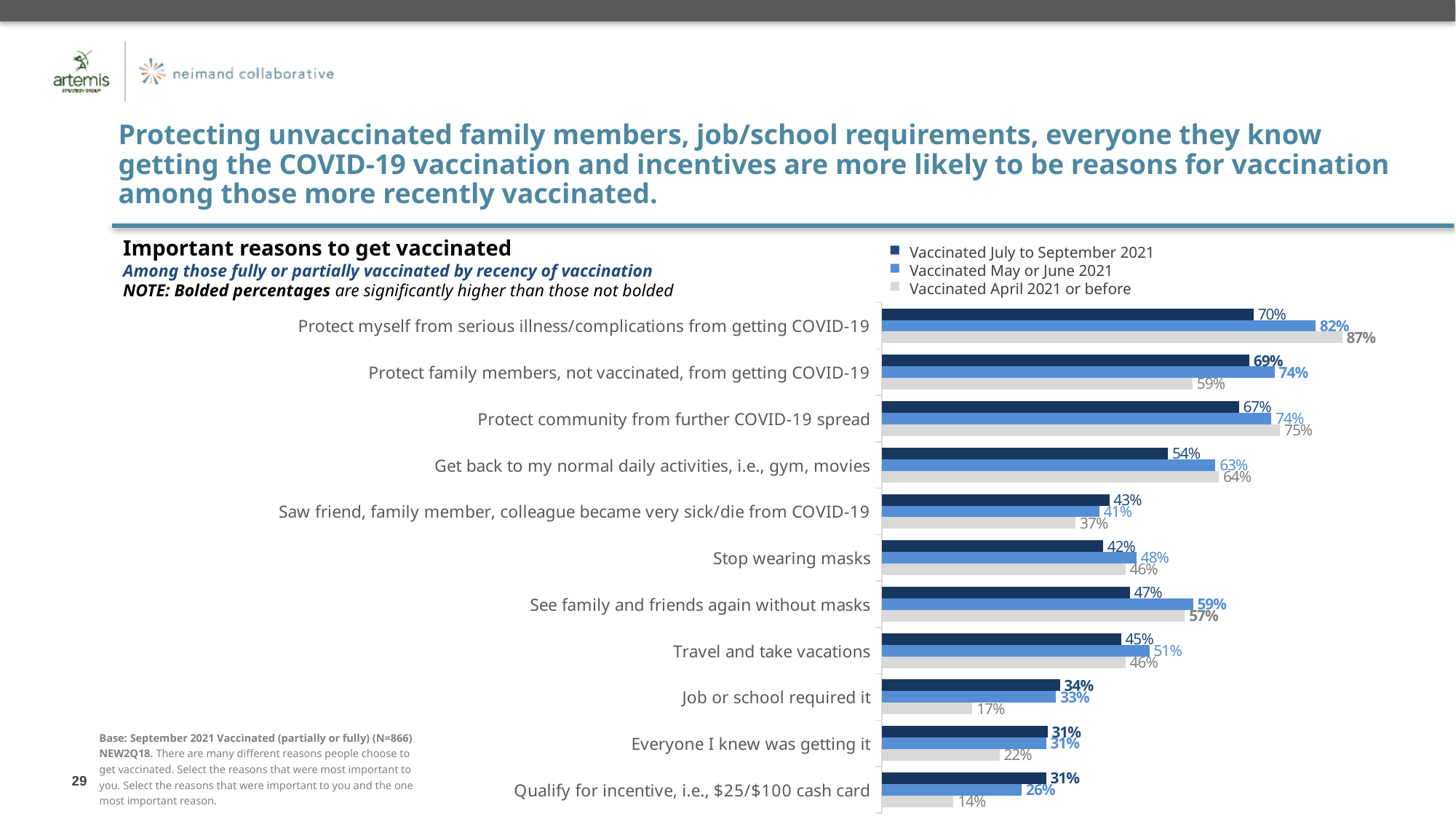
Which legend entry is represented by the grey bars? Vaccinated April 2021 or before What percentage of those vaccinated April 2021 or before cited "Protect myself from serious illness/complications from getting COVID-19" as an important reason? 87% For "Protect family members, not vaccinated, from getting COVID-19", which group has the larger value: vaccinated May or June 2021 or vaccinated April 2021 or before? Vaccinated May or June 2021 Which reason has the lowest value for those vaccinated April 2021 or before? Qualify for incentive, i.e., $25/$100 cash card What is the difference between the July to September 2021 and April 2021 or before values for "Job or school required it"? 17 percentage points How many series does the legend list? 3 What type of chart is shown on the slide? Bar chart What is the value for "Job or school required it" among those vaccinated July to September 2021? 34% Which reason has the highest value for those vaccinated April 2021 or before? Protect myself from serious illness/complications from getting COVID-19 What is the difference between the May or June 2021 and April 2021 or before values for "Everyone I knew was getting it"? 9 percentage points What percentage of those vaccinated May or June 2021 cited "Qualify for incentive, i.e., $25/$100 cash card"? 26% How many reasons (categories) are shown in the chart? 11